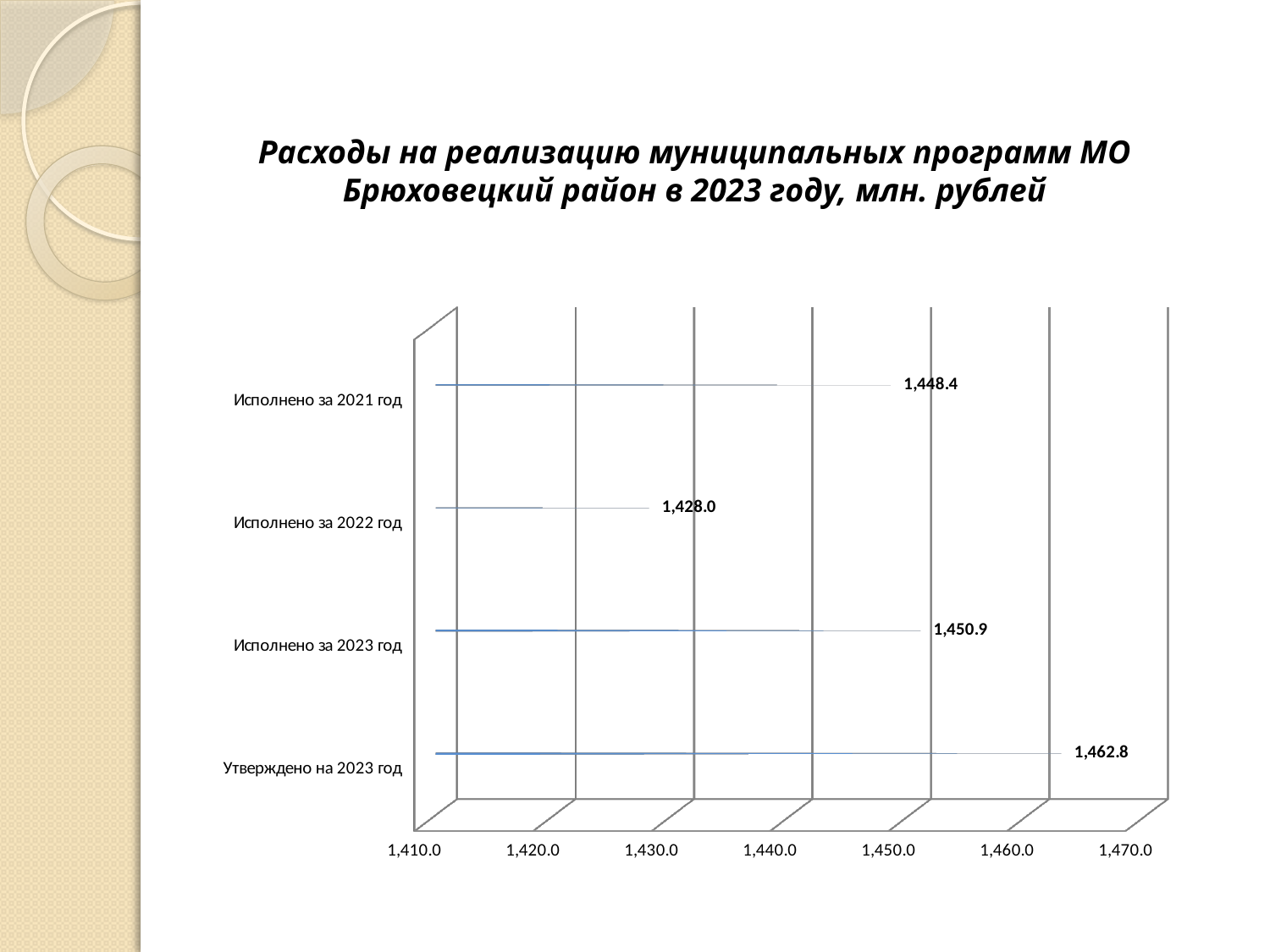
What is the value for "Утверждено на 2023 год"? 1,462.8 What kind of chart is shown on the slide? Bar chart What is the value for "Исполнено за 2021 год"? 1,448.4 Which is larger: the value for "Исполнено за 2023 год" or the value for "Исполнено за 2021 год"? Исполнено за 2023 год What is the difference between the value for "Исполнено за 2021 год" and the value for "Исполнено за 2022 год"? 20.4 What is the value for "Исполнено за 2022 год"? 1,428.0 Which category has the highest value? Утверждено на 2023 год Which category has the lowest value? Исполнено за 2022 год What is the value for "Исполнено за 2023 год"? 1,450.9 What is the difference between the value for "Утверждено на 2023 год" and the value for "Исполнено за 2023 год"? 11.9 What is the title of the chart? Расходы на реализацию муниципальных программ МО Брюховецкий район в 2023 году, млн. рублей How many categories are shown in the chart? 4